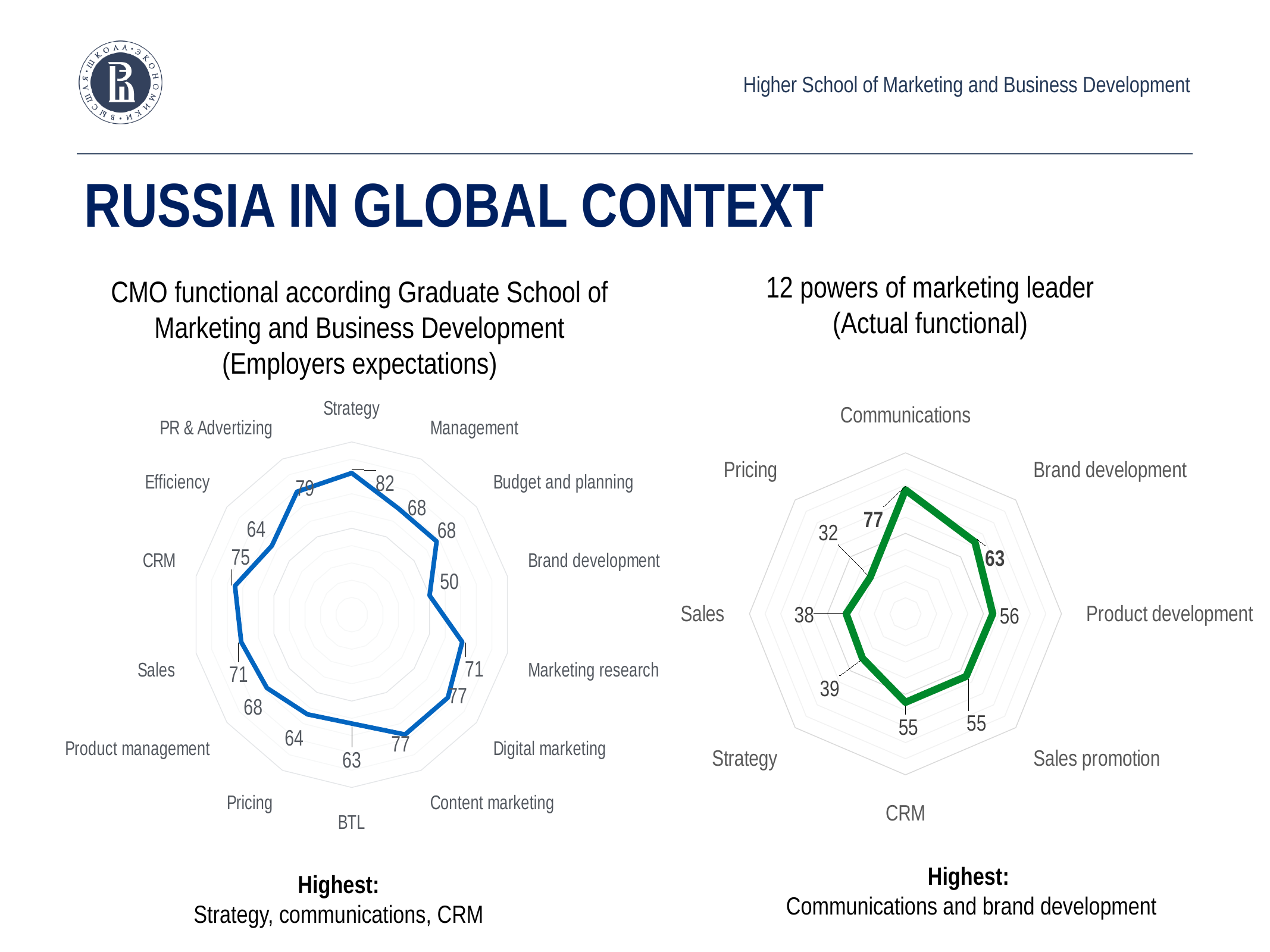
On the left chart (Employers expectations), which category has the highest value? Strategy On the right chart (Actual functional), which category has the lowest value? Pricing On the right chart (Actual functional), what is the value for Communications? 77 On the left chart (Employers expectations), what is the difference between the values for CRM and BTL? 12 On the right chart (Actual functional), what is the difference between the values for Brand development and Sales? 25 What kind of chart is the left chart (Employers expectations)? Radar chart On the right chart (Actual functional), what is the value for Pricing? 32 On the left chart (Employers expectations), which is larger: PR & Advertizing or Efficiency? PR & Advertizing On the left chart (Employers expectations), which category has the lowest value? Brand development On the left chart (Employers expectations), what is the value for Strategy? 82 How many categories are plotted on the right chart (Actual functional)? 8 On the left chart (Employers expectations), what is the value for Brand development? 50